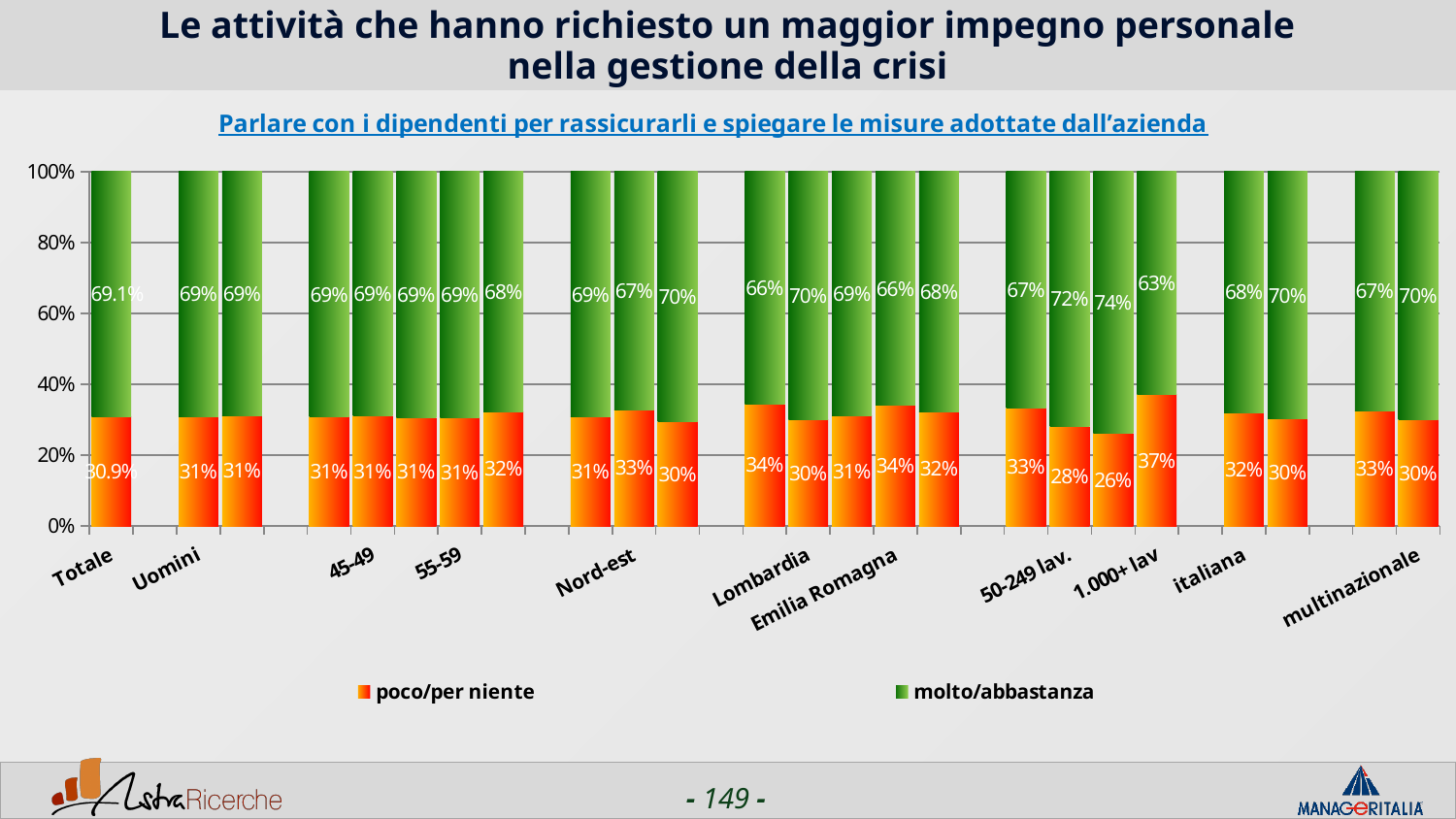
What is the value of molto/abbastanza for multinazionale? 70% What is the difference between molto/abbastanza and poco/per niente for Totale? 38.2 percentage points What is the value of poco/per niente for Totale? 30.9% What is the value of poco/per niente for 45-49? 31% What are the two series named in the legend? poco/per niente and molto/abbastanza For Totale, which is larger: molto/abbastanza or poco/per niente? molto/abbastanza What is the value of poco/per niente for 1.000+ lav? 37% What is the value of molto/abbastanza for Totale? 69.1% What is the value of molto/abbastanza for 55-59? 69% What kind of chart is shown on the slide? Stacked bar chart What is the value of molto/abbastanza for Uomini? 69% How many series does the legend list? 2